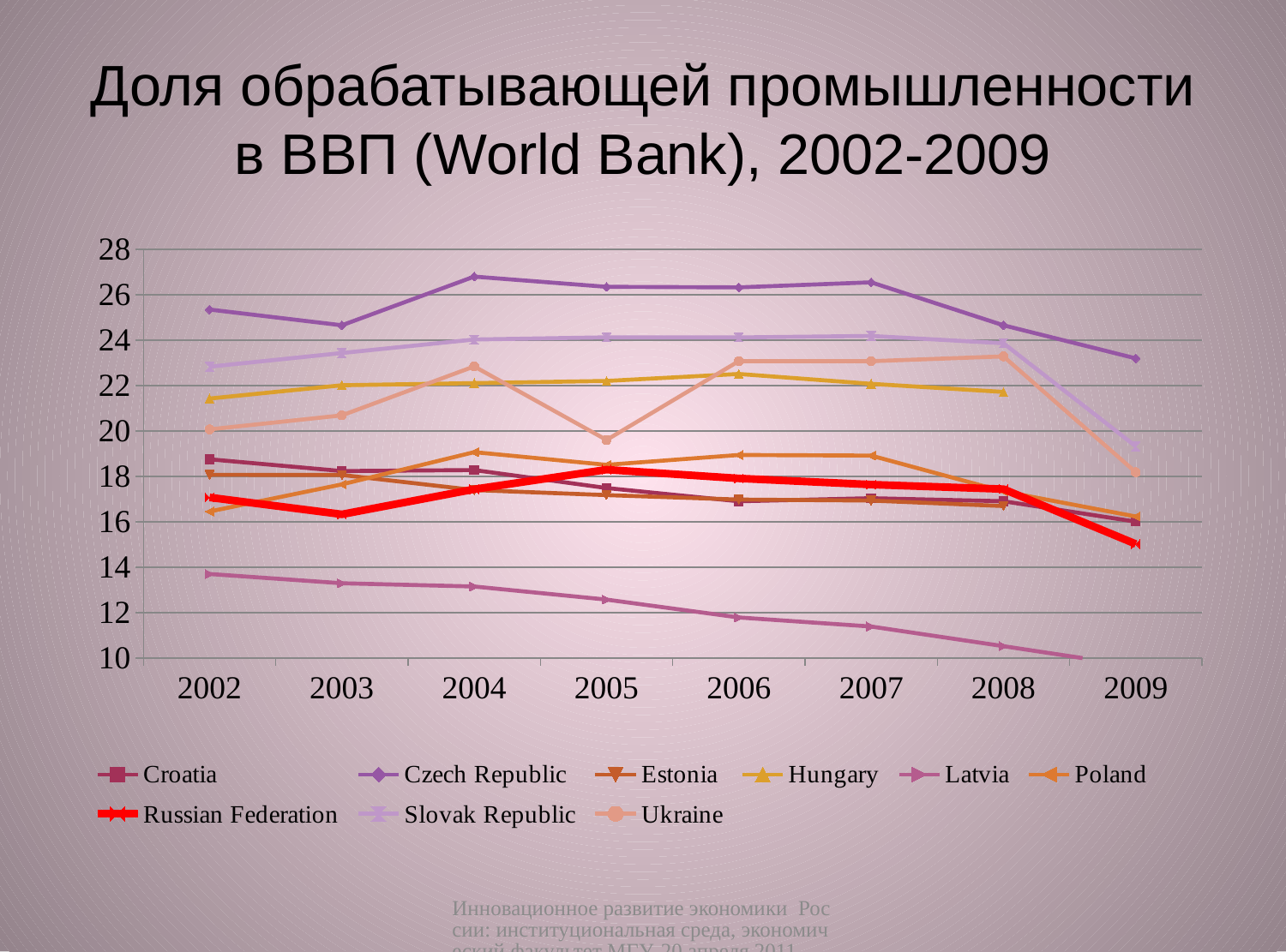
Which is larger in 2002, the value for Czech Republic or the value for Slovak Republic? Czech Republic Is the value for Slovak Republic in 2009 greater or less than 20? less Is the value for Latvia in 2002 greater or less than 12? greater Does the value for Latvia rise or fall from 2002 to 2009? fall Which country has the lowest value in 2009? Latvia How many years are shown along the x axis? 8 Which country has the highest value in 2002? Czech Republic Is the value for Russian Federation in 2009 greater or less than 16? less How many series does the legend list? 9 Which series is drawn with the thick red line? Russian Federation What kind of chart is shown on the slide? line chart